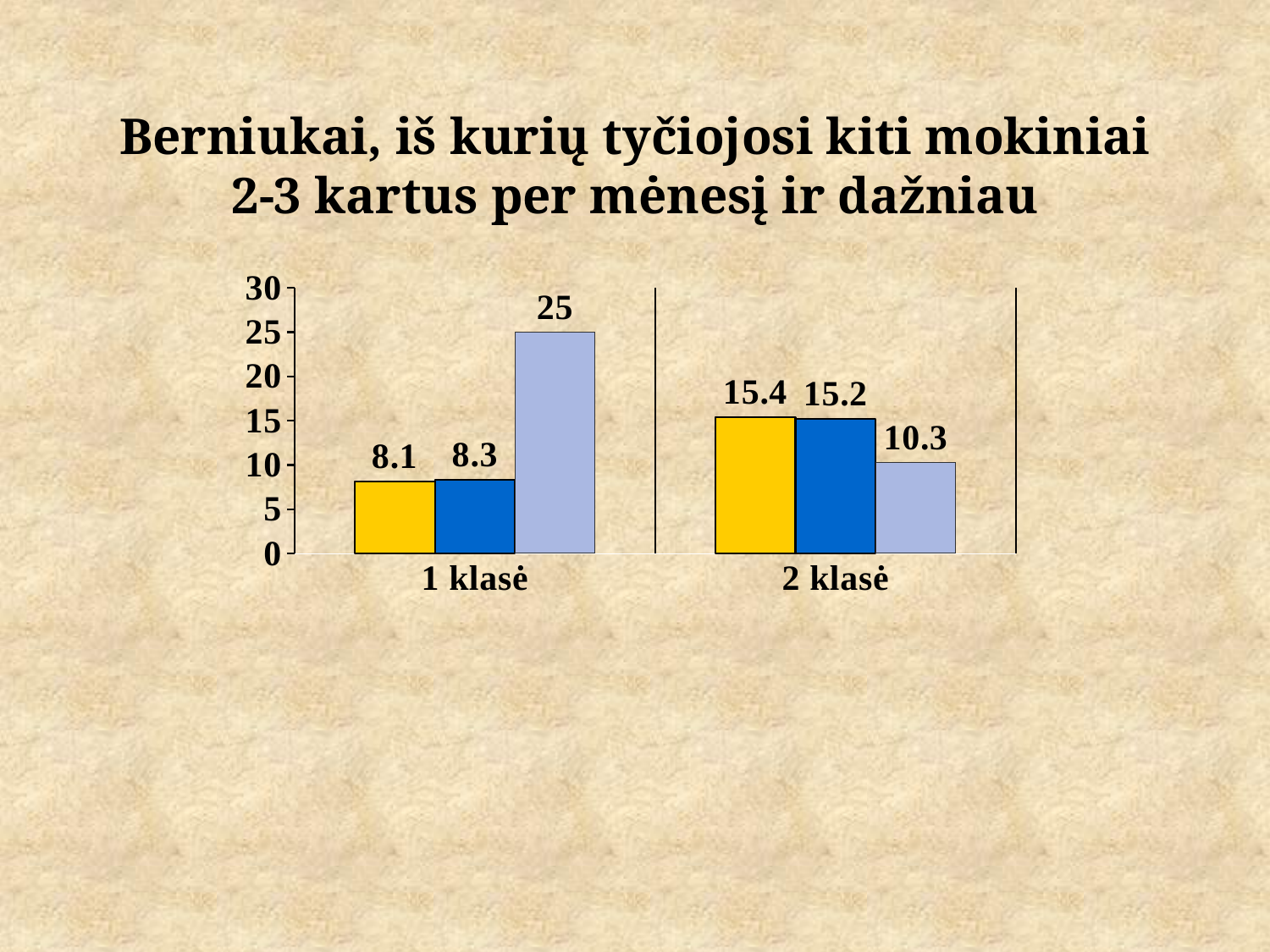
Which is larger: the light blue bar for 1 klasė or the light blue bar for 2 klasė? The light blue bar for 1 klasė What is the value of the yellow bar for 2 klasė? 15.4 What is the value of the light blue bar for 1 klasė? 25 What is the title of the chart on the slide? Berniukai, iš kurių tyčiojosi kiti mokiniai 2-3 kartus per mėnesį ir dažniau What is the difference between the yellow bar for 2 klasė and the yellow bar for 1 klasė? 7.3 How many categories are shown on the x axis? 2 Which bar has the lowest value on the chart? The yellow bar for 1 klasė (8.1) What is the difference between the light blue bar for 1 klasė and the light blue bar for 2 klasė? 14.7 What is the value of the light blue bar for 2 klasė? 10.3 Which bar has the highest value on the chart? The light blue bar for 1 klasė (25) What is the value of the dark blue bar for 1 klasė? 8.3 What type of chart is shown on the slide? Bar chart